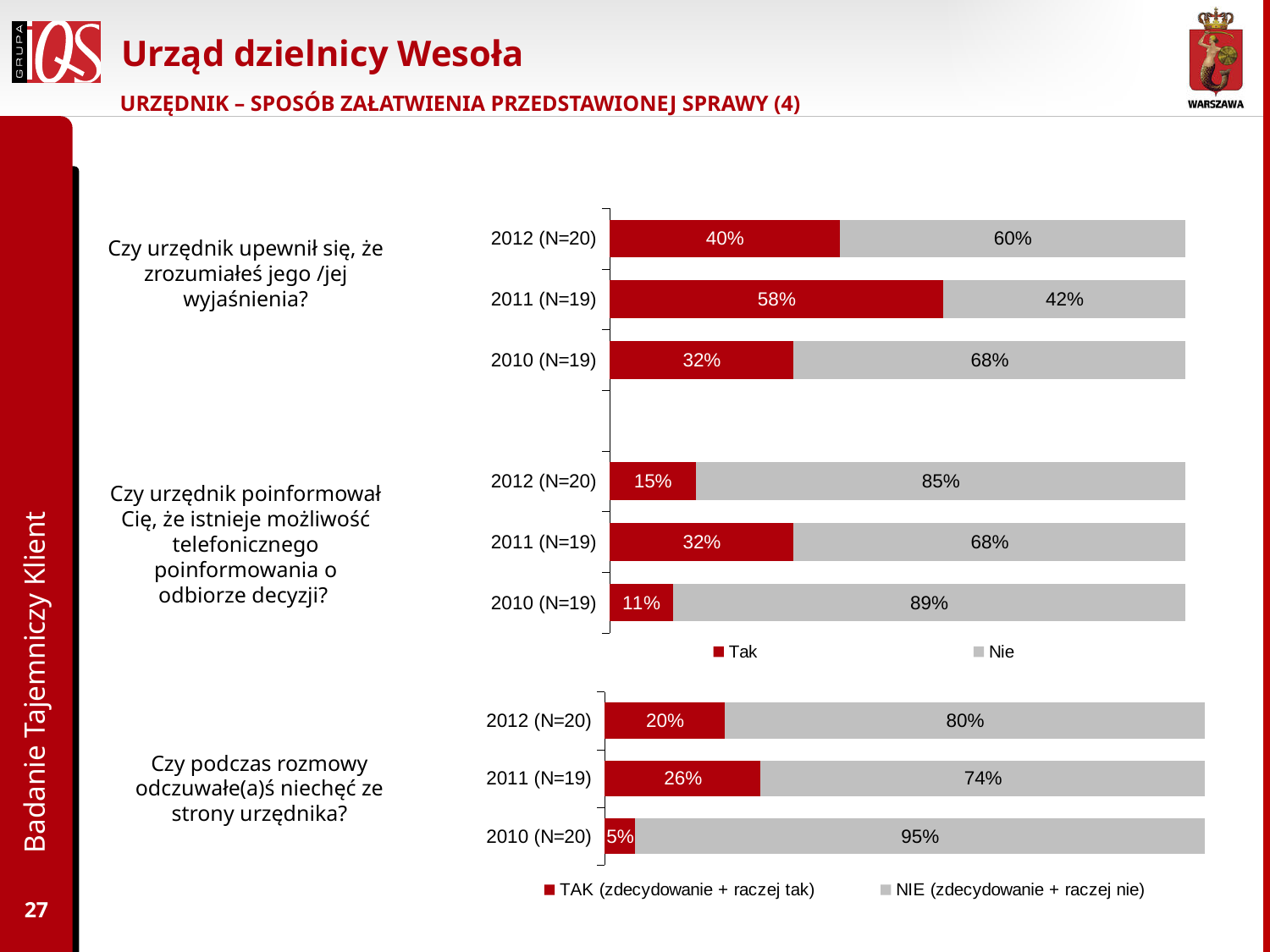
In the middle chart, is the "Tak" value for 2011 (N=19) larger or smaller than the "Tak" value for 2012 (N=20)? larger What type of chart is used on this slide? Stacked bar chart In the middle chart ("Czy urzędnik poinformował Cię, że istnieje możliwość telefonicznego poinformowania o odbiorze decyzji?"), what is the "Nie" value for 2012 (N=20)? 85% In the bottom chart, what is the "NIE" value for 2011 (N=19)? 74% In the bottom chart, what is the total of the stacked bar for 2012 (N=20)? 100% In the bottom chart ("Czy podczas rozmowy odczuwałe(a)ś niechęć ze strony urzędnika?"), what is the "TAK" value for 2010 (N=20)? 5% How many year categories does the bottom chart show? 3 In the top chart ("Czy urzędnik upewnił się, że zrozumiałeś jego/jej wyjaśnienia?"), what is the "Tak" value for 2012 (N=20)? 40% In the top chart, which year has the highest "Tak" share? 2011 (N=19) In the middle chart, which year has the lowest "Tak" share? 2010 (N=19) In the top chart, what is the difference between the "Tak" values for 2011 (N=19) and 2010 (N=19)? 26 percentage points In the top chart, what is the "Nie" value for 2010 (N=19)? 68%